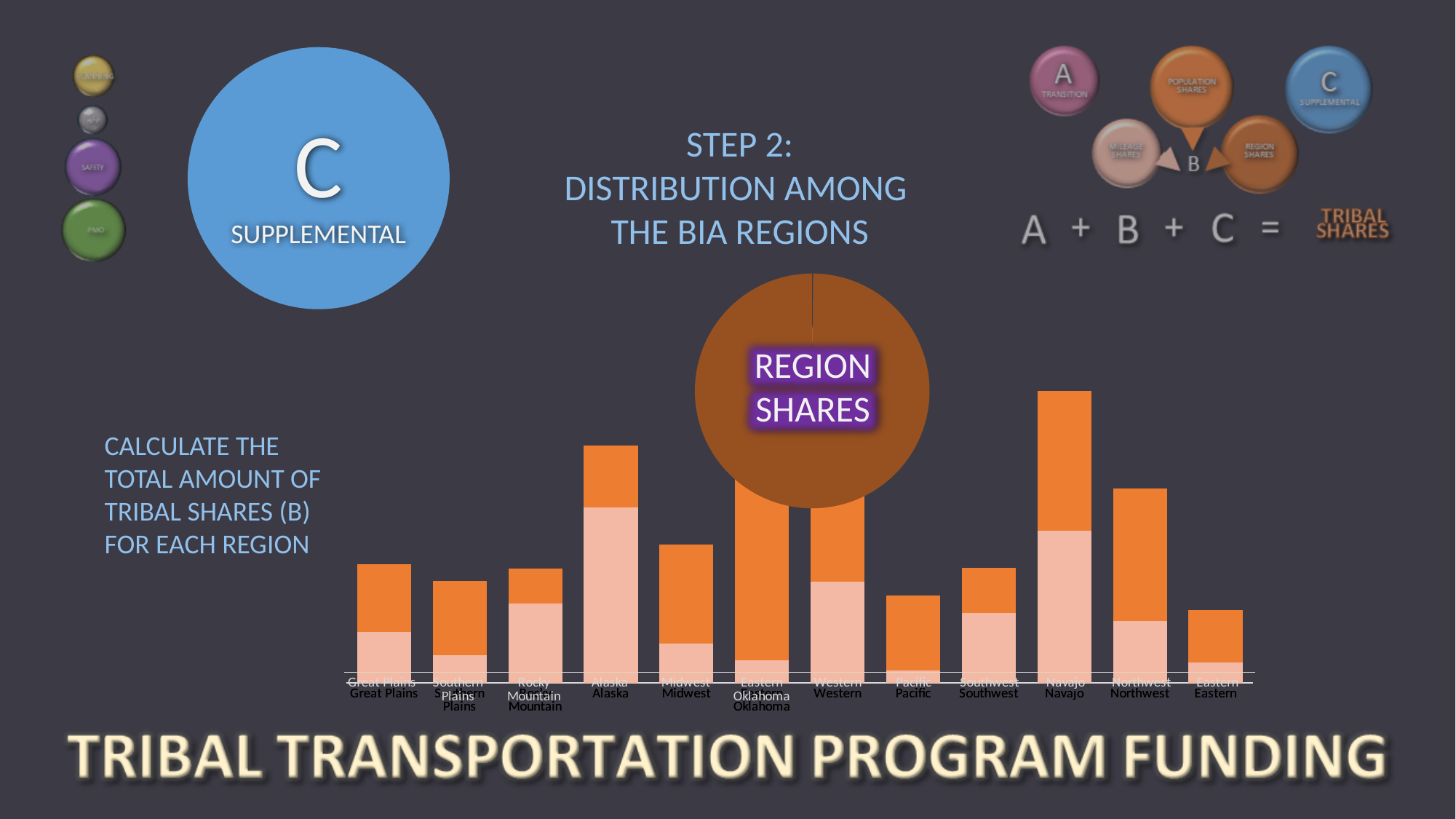
How many regions (categories) are shown along the x axis of the bar chart? 12 What label is shown in the circle overlaying the top of the bar chart? REGION SHARES What kind of chart is shown on the slide? stacked bar chart Which bar is taller, Pacific or Navajo? Navajo Which bar is taller, Alaska or Navajo? Navajo Which region's bar is the first category on the left of the x axis? Great Plains Which bar is taller, Rocky Mountain or Alaska? Alaska